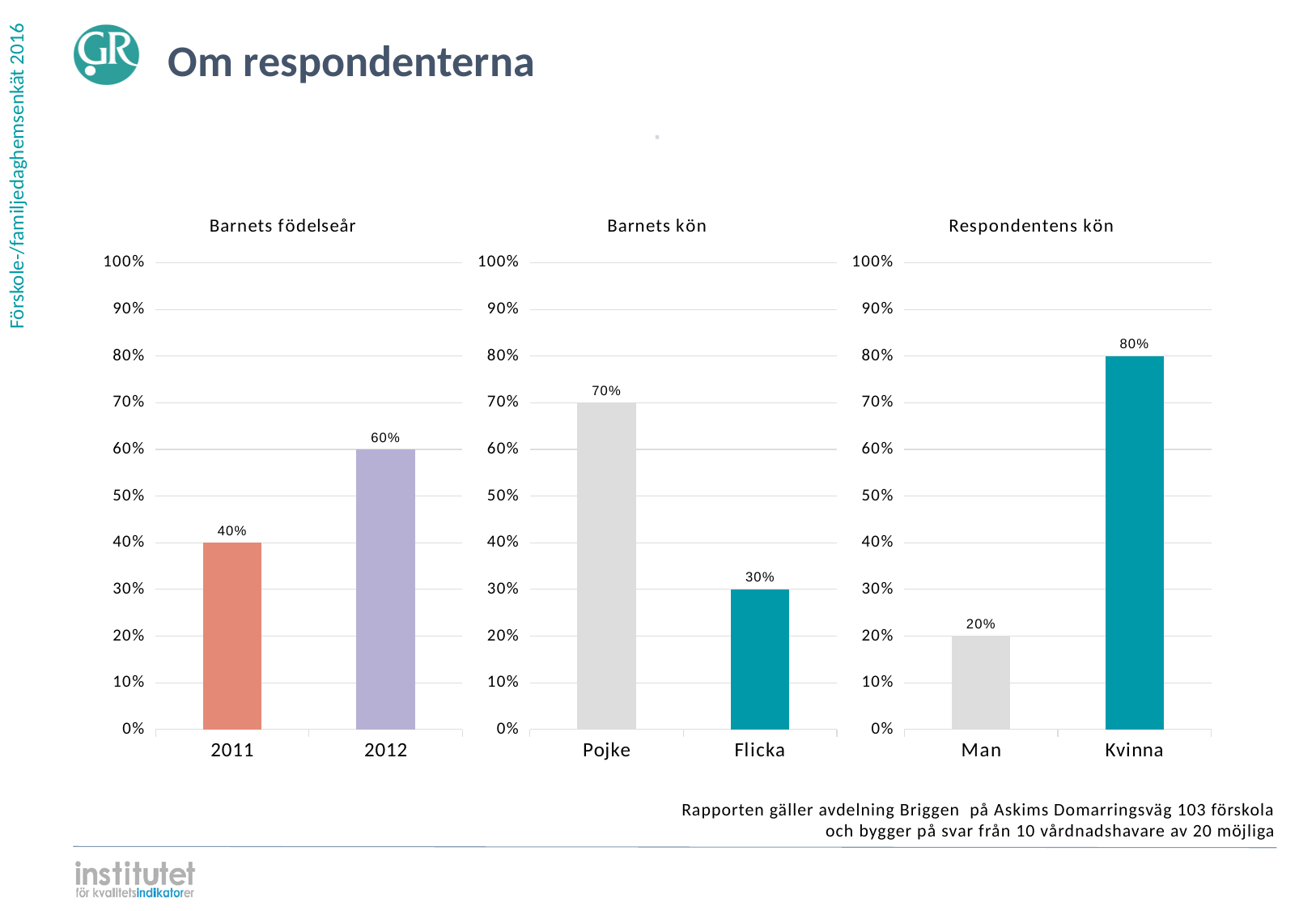
In the 'Barnets födelseår' chart, what is the value for 2011? 40% In the 'Barnets kön' chart, what is the value for Pojke? 70% In the 'Barnets födelseår' chart, which is larger, the value for 2011 or 2012? 2012 In the 'Respondentens kön' chart, which category has the lowest value? Man In the 'Barnets kön' chart, which category has the highest value? Pojke In the 'Barnets kön' chart, what is the value for Flicka? 30% How many categories are shown in the 'Barnets födelseår' chart? 2 In the 'Barnets kön' chart, is the value for Pojke greater or less than 50%? greater What kind of chart is the 'Respondentens kön' chart? bar chart In the 'Barnets födelseår' chart, what is the value for 2012? 60% In the 'Respondentens kön' chart, what is the value for Kvinna? 80% In the 'Respondentens kön' chart, what is the difference between the values for Kvinna and Man? 60%